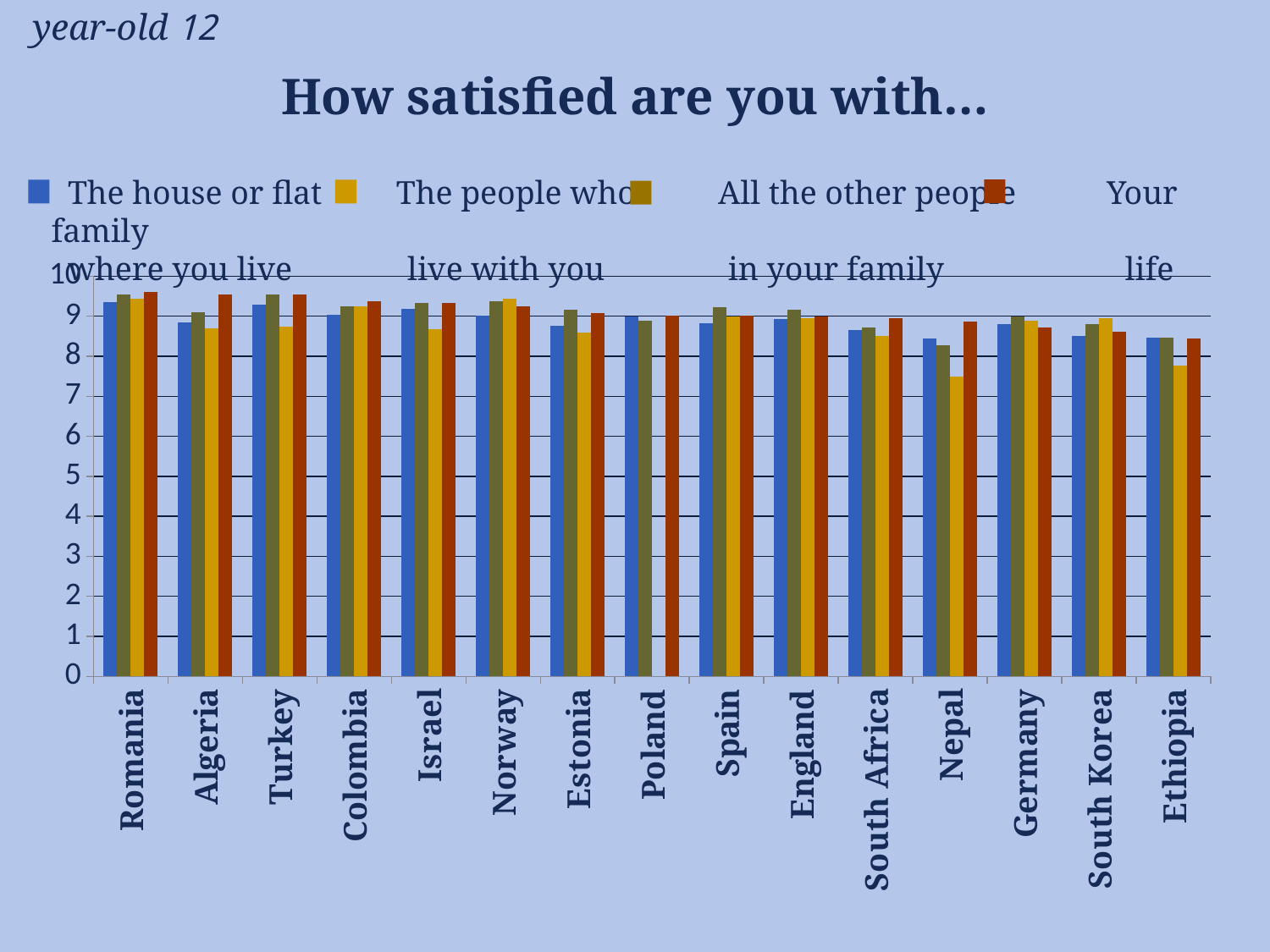
Which country is listed first on the x axis? Romania Is the value for 'The house or flat where you live' in Nepal greater or less than 9? less What is the title of the chart? How satisfied are you with... Which country has the lowest value for 'The people who live with you'? Nepal Is the value for 'The people who live with you' in Nepal greater or less than 8? greater How many series does the chart's legend list? 4 How many countries are shown on the x axis of the chart? 15 What kind of chart is shown on the slide? Bar chart